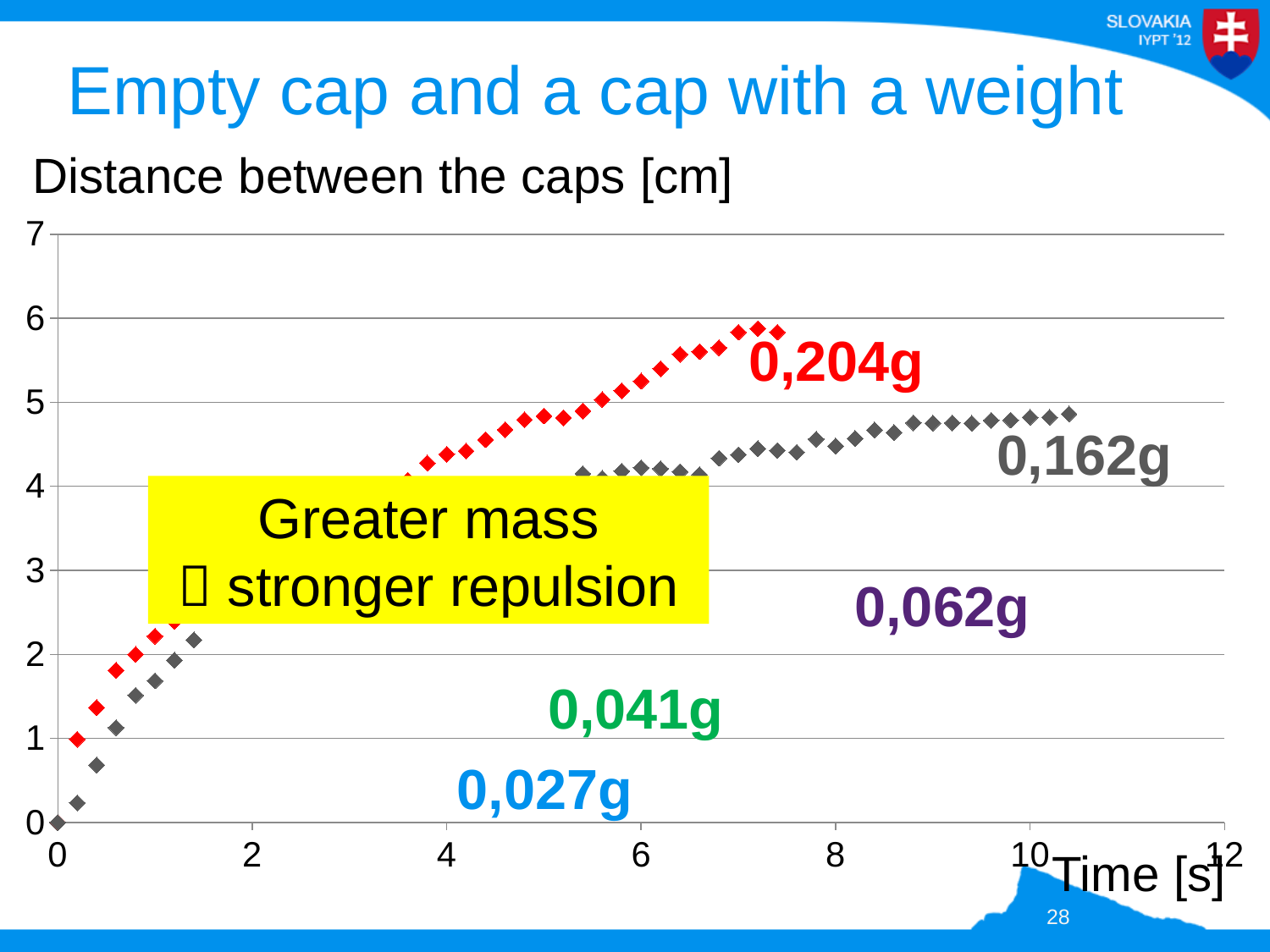
Do the values of the grey 0,162g series rise or fall as time increases? rise Which of the two visible series, 0,204g or 0,162g, reaches the highest distance between the caps? 0,204g At time 6 s, which series has the larger distance, the red 0,204g series or the grey 0,162g series? the red 0,204g series Is the highest value of the grey 0,162g series greater or less than 5? less Do the values of the red 0,204g series rise or fall as time increases? rise Is the value of the grey 0,162g series at time 8 s greater or less than 4? greater Is the highest value of the red 0,204g series greater or less than 6? less What is the maximum value shown on the time axis? 12 What is the title of the chart? Empty cap and a cap with a weight What kind of chart is shown on the slide? scatter chart What quantity is plotted on the vertical axis? Distance between the caps [cm]